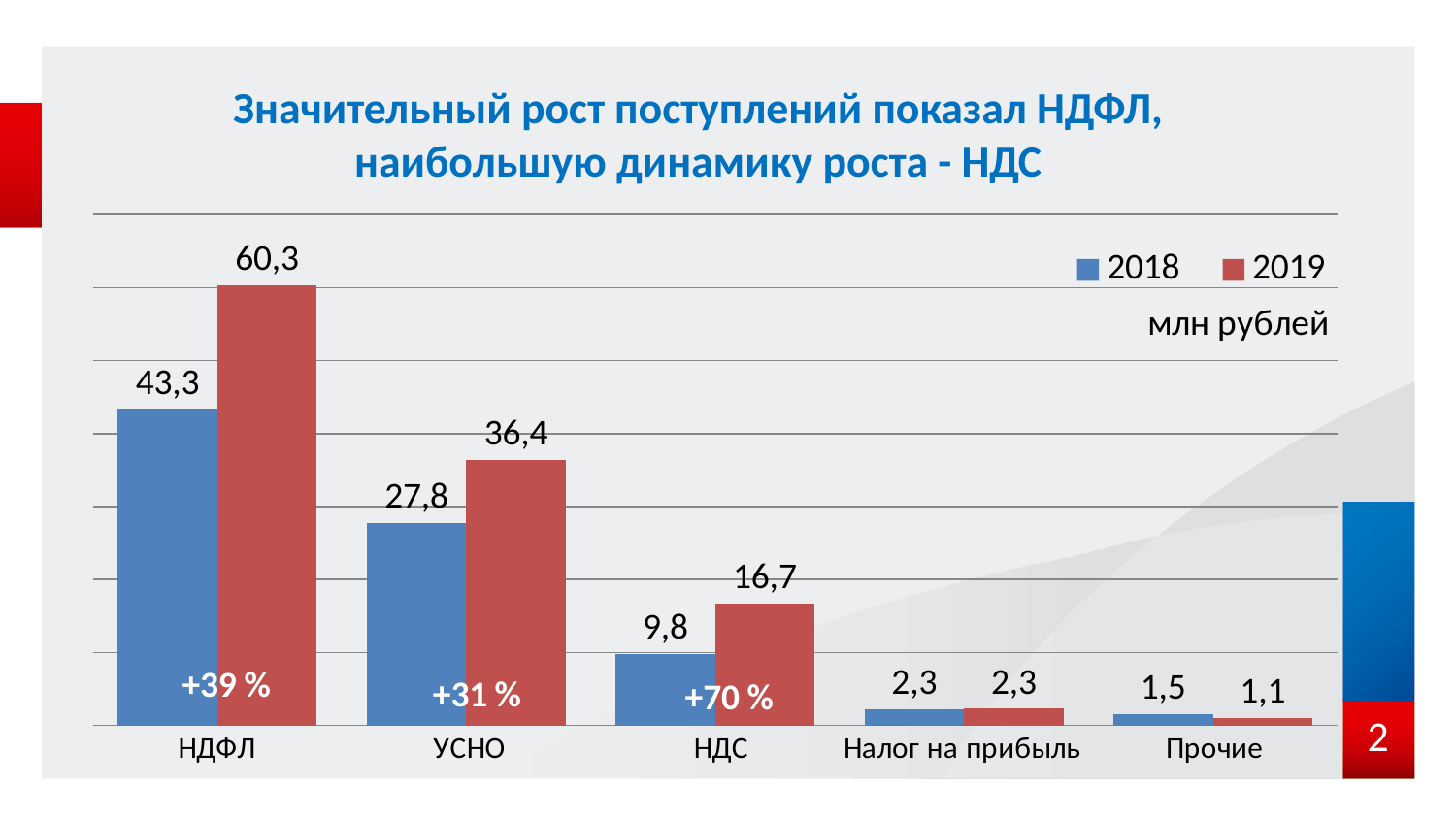
How many categories are shown on the x axis? 5 Which category has the lowest value in 2019? Прочие What growth percentage is printed on the НДС bars? +70 % Which category has the highest value in 2019? НДФЛ How many series does the legend list? 2 What is the value for УСНО in 2018? 27,8 What is the value for НДС in 2019? 16,7 What is the difference between the 2019 and 2018 values for НДФЛ? 17,0 What is the value for НДФЛ in 2019? 60,3 What kind of chart is shown on the slide? bar chart What is the value for Прочие in 2018? 1,5 Which is larger for Прочие: the 2018 value or the 2019 value? 2018